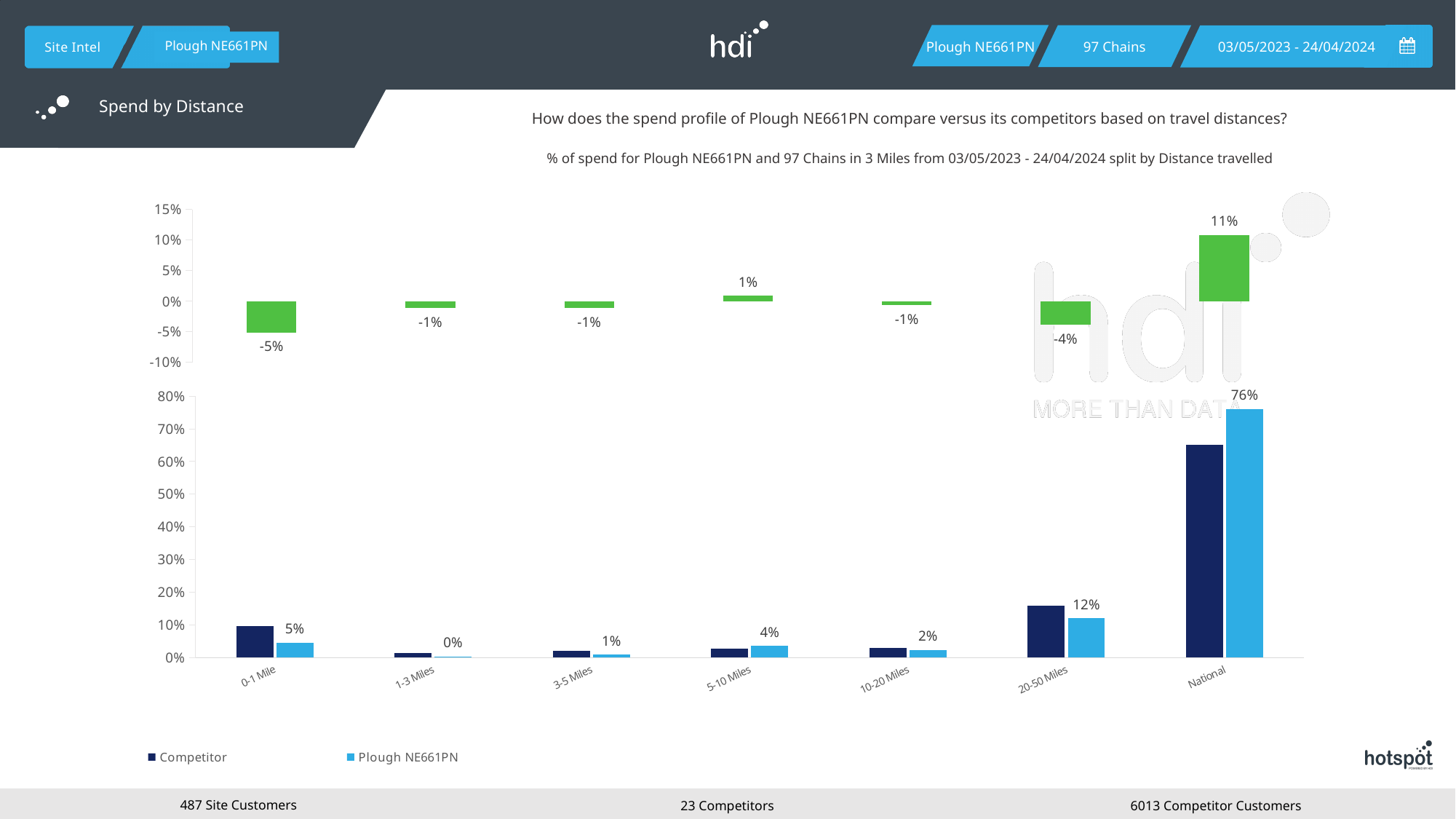
In the top chart, which category has the highest value? National How many series does the legend of the bottom chart list? 2 In the bottom chart, is the Competitor value for 20-50 Miles greater or less than 20%? less In the top chart, what is the value shown for 0-1 Mile? -5% In the bottom chart, what is the value for Plough NE661PN in the National category? 76% How many distance categories are shown on the x axis of the bottom chart? 7 In the bottom chart, is the Competitor value for National greater or less than 60%? greater In the bottom chart, at 0-1 Mile, which series has the larger value: Competitor or Plough NE661PN? Competitor What type of chart is the bottom chart? Bar chart In the bottom chart, what is the value for Plough NE661PN at 20-50 Miles? 12% In the bottom chart, what is the difference between the Plough NE661PN values for National and 20-50 Miles? 64% In the top chart, which category has the lowest value? 0-1 Mile